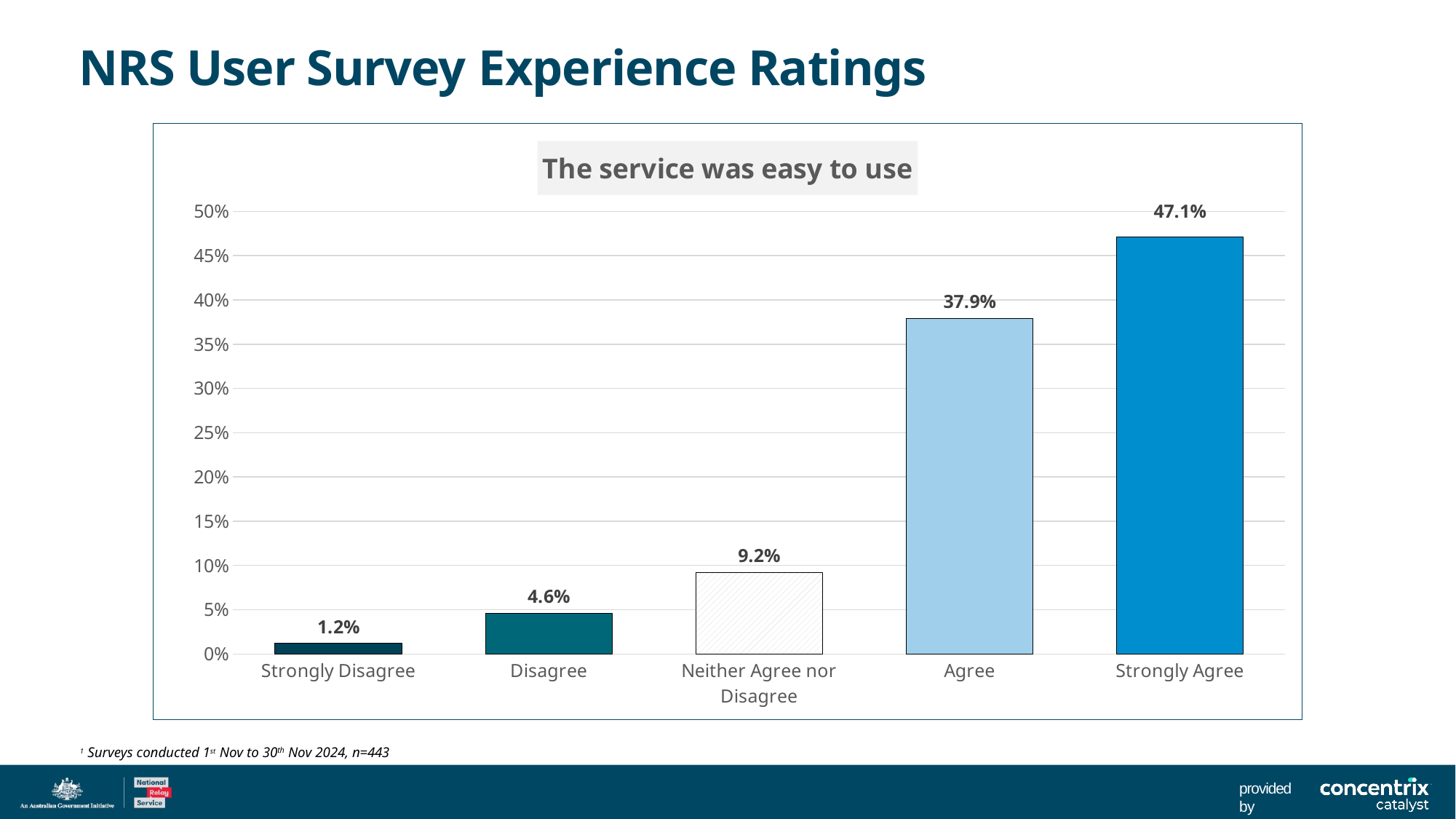
What percentage of respondents selected Strongly Agree? 47.1% What is the value for Neither Agree nor Disagree? 9.2% Is the value for Agree greater or less than 35%? greater What is the title of the chart? The service was easy to use Which response category has the lowest value? Strongly Disagree Do the values rise or fall moving from Strongly Disagree to Strongly Agree along the x axis? Rise How many response categories are shown on the x axis? 5 Which is larger, the value for Disagree or the value for Neither Agree nor Disagree? Neither Agree nor Disagree What is the difference between the Strongly Agree and Agree values? 9.2% What kind of chart is shown on the slide? Bar chart What percentage of respondents selected Disagree? 4.6% Which response category has the highest value? Strongly Agree